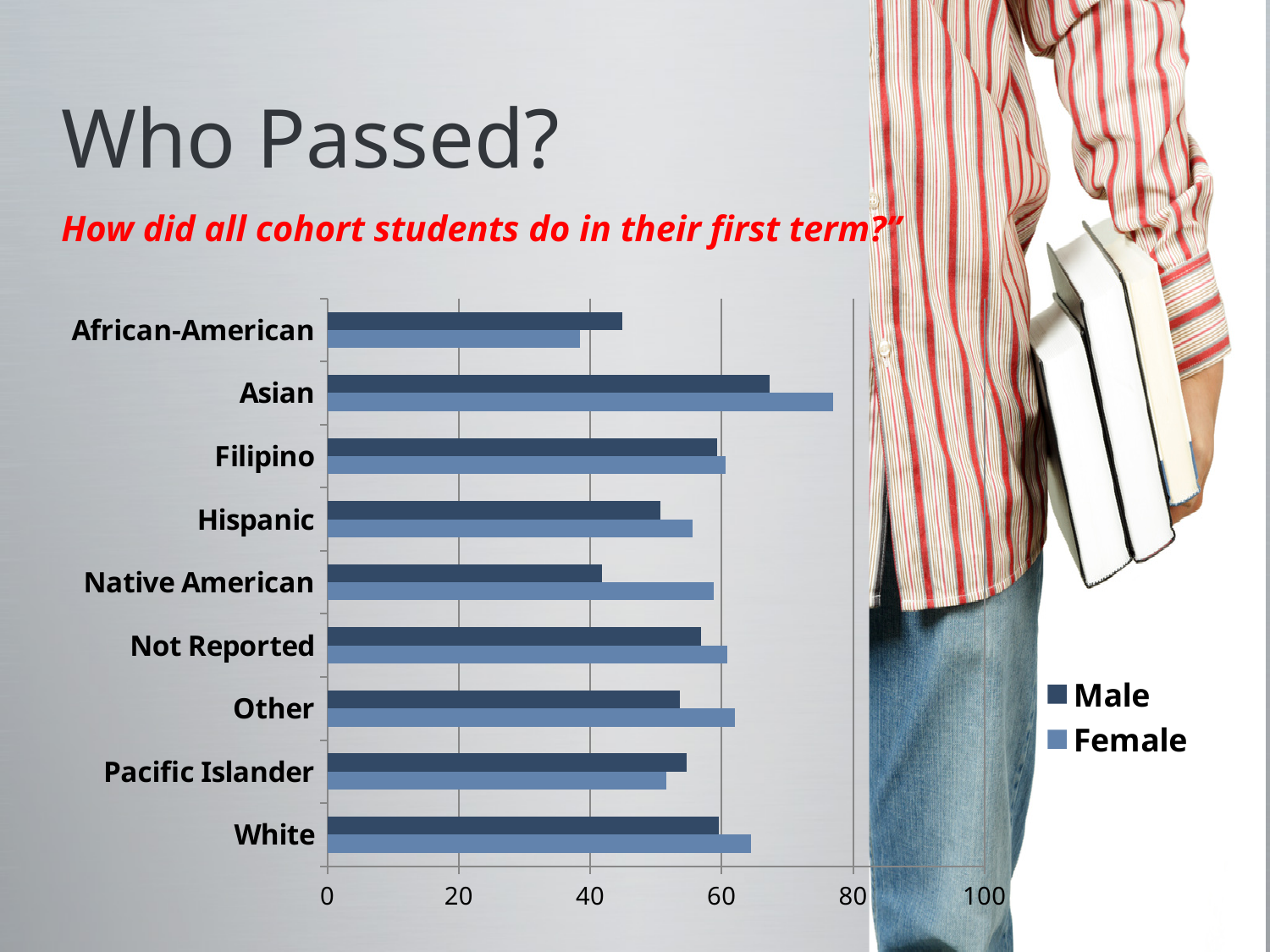
What kind of chart is shown on the slide? bar chart Which category has the lowest Female value? African-American Which category has the highest Female value? Asian For Native American, which is larger, the Male value or the Female value? Female How many series does the legend list? 2 How many categories are shown on the chart? 9 Is the Female value for African-American greater or less than 40? less What are the two series listed in the legend? Male and Female Which category has the highest Male value? Asian Is the Female value for Asian greater or less than 60? greater Is the Male value for Native American greater or less than 60? less